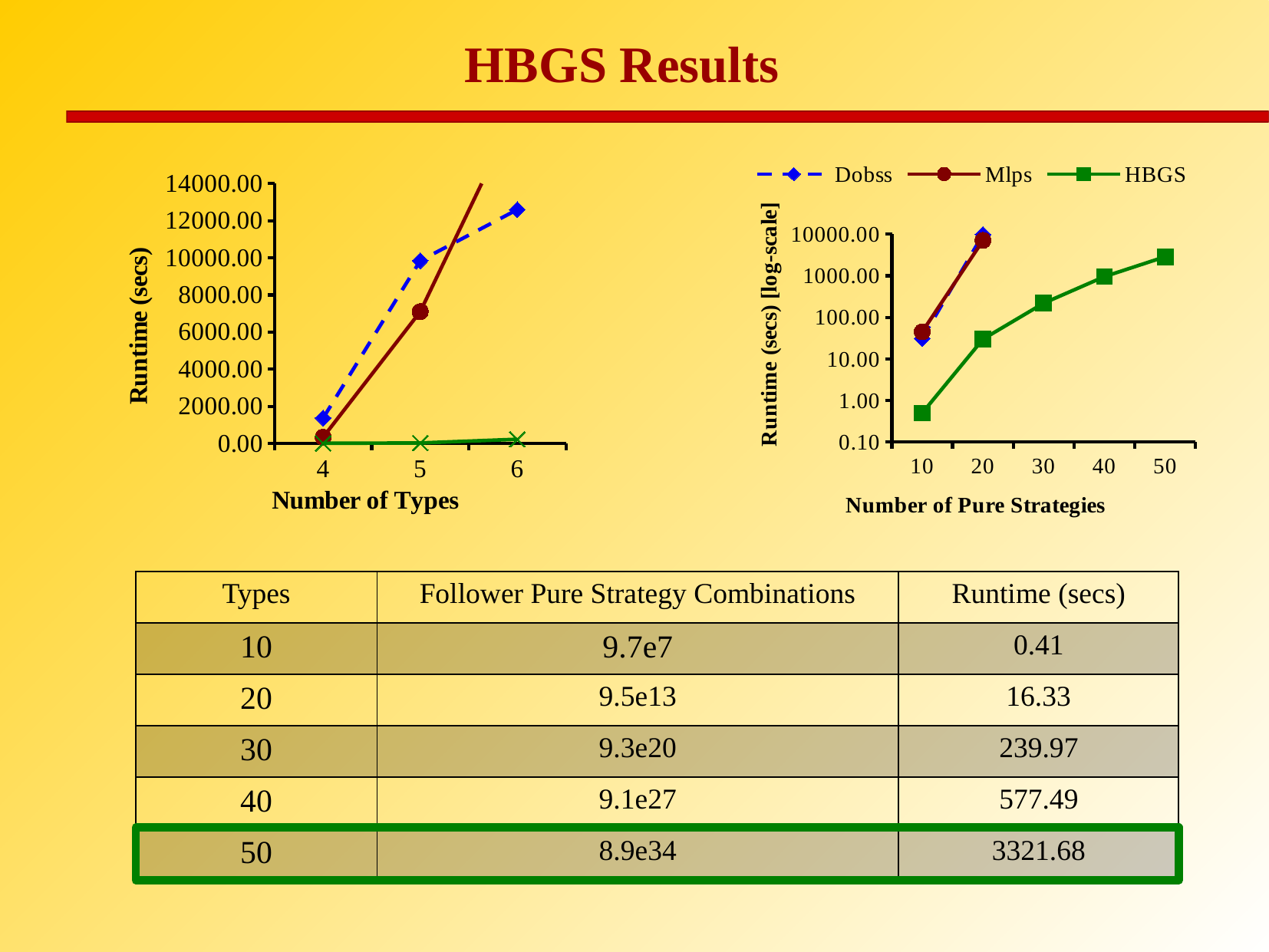
What kind of chart is the left chart with the x axis 'Number of Types'? line chart In the left chart ('Number of Types'), is the Mlps runtime at 5 types greater or less than 8000.00? less In the left chart ('Number of Types'), which series has the larger runtime at 5 types, Dobss or Mlps? Dobss In the right chart ('Number of Pure Strategies'), how many x-axis values are shown? 5 In the right chart ('Number of Pure Strategies'), is the HBGS runtime at 50 pure strategies greater or less than 1000.00? greater In the right chart ('Number of Pure Strategies'), is the HBGS runtime at 10 pure strategies greater or less than 1.00? less How many series does the legend list? 3 In the left chart ('Number of Types'), which series has the larger runtime at 4 types, Dobss or HBGS? Dobss In the left chart ('Number of Types'), how many points are on the x axis? 3 In the right chart ('Number of Pure Strategies'), does the HBGS runtime rise or fall as the number of pure strategies increases? rise Which series in the legend is drawn with a dashed line? Dobss